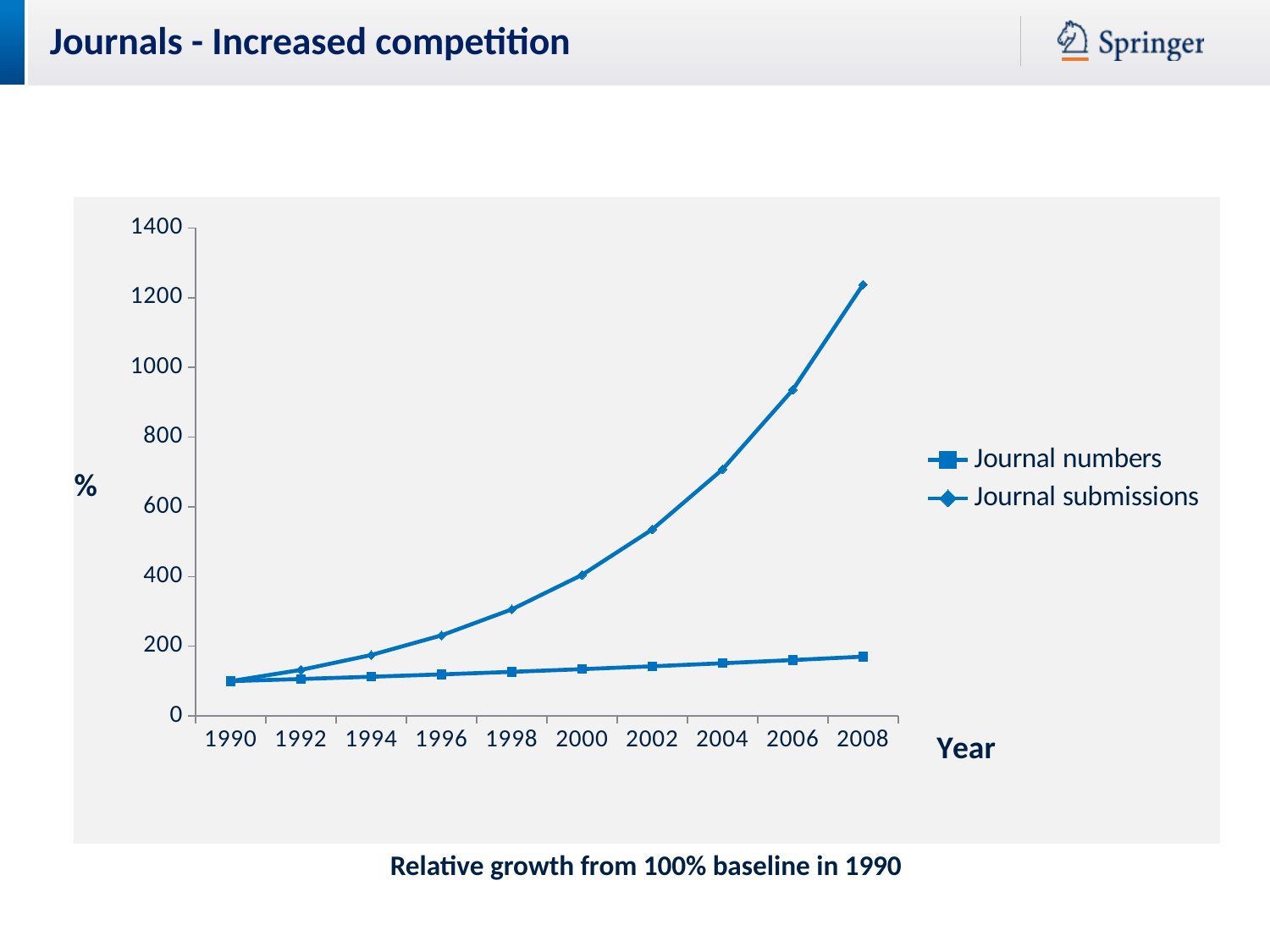
Is the value for Journal submissions in 2006 greater or less than 800? greater How many years are plotted along the x axis? 10 Is the value for Journal submissions in 2008 greater or less than 1000? greater Do the values for Journal submissions rise or fall from 1990 to 2008? rise In 2008, which series has the larger value, Journal numbers or Journal submissions? Journal submissions Is the value for Journal submissions in 2002 greater or less than 400? greater What kind of chart is shown on the slide? line chart In which year is the value for Journal submissions lowest? 1990 How many series does the legend list? 2 What is the label on the x axis of the chart? Year In which year is the value for Journal submissions highest? 2008